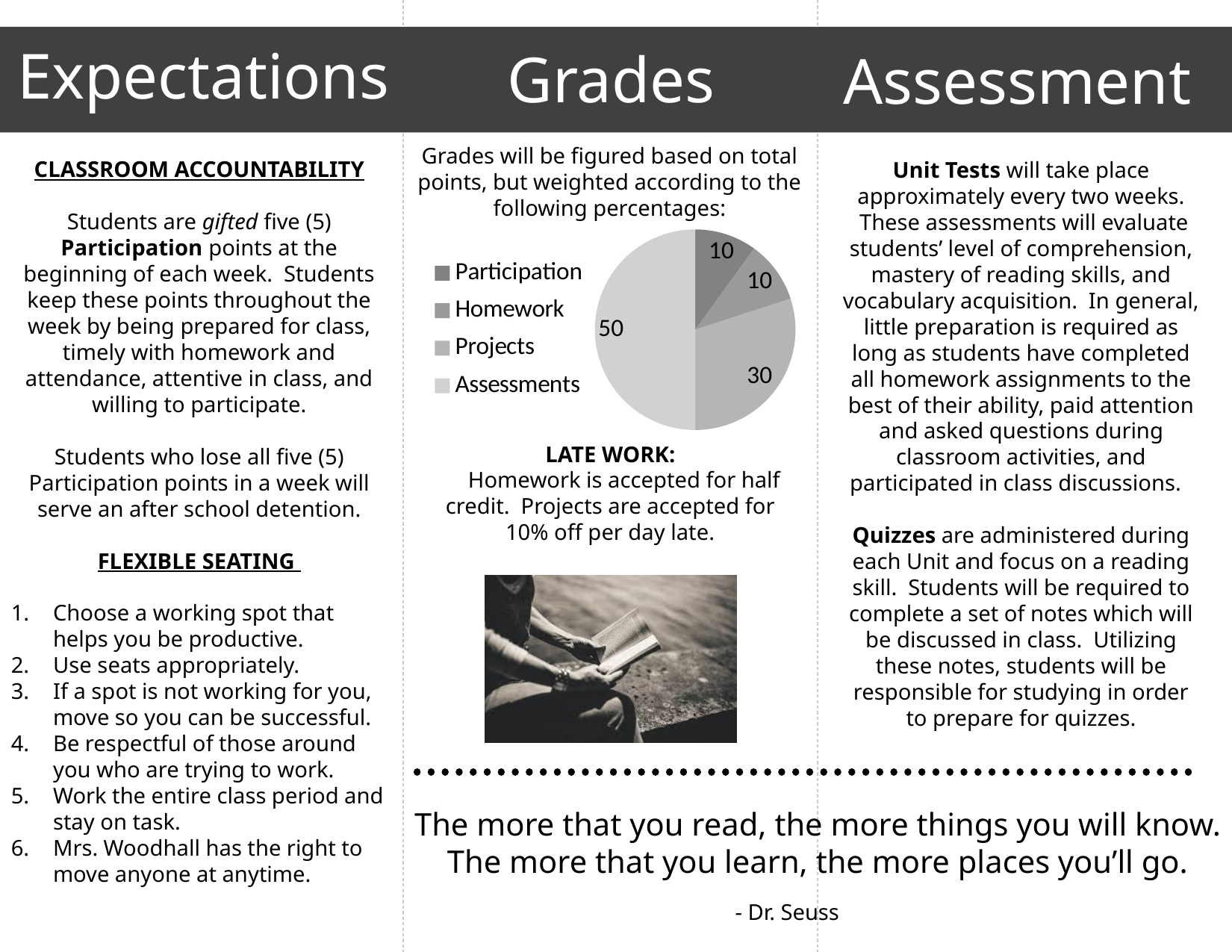
What is the total of all the values shown in the pie chart? 100 What value is shown for Assessments in the pie chart? 50 What is the difference between the Assessments value and the Projects value in the pie chart? 20 What share of the pie does the Assessments slice represent? 50% What value is shown for Participation in the pie chart? 10 What value is shown for Homework in the pie chart? 10 Which is larger in the pie chart, Projects or Homework? Projects How many categories does the pie chart's legend list? 4 Which category has the largest slice in the pie chart? Assessments What kind of chart is shown on the slide? pie chart What value is shown for Projects in the pie chart? 30 Which legend entry in the pie chart is shown in the lightest shade? Assessments